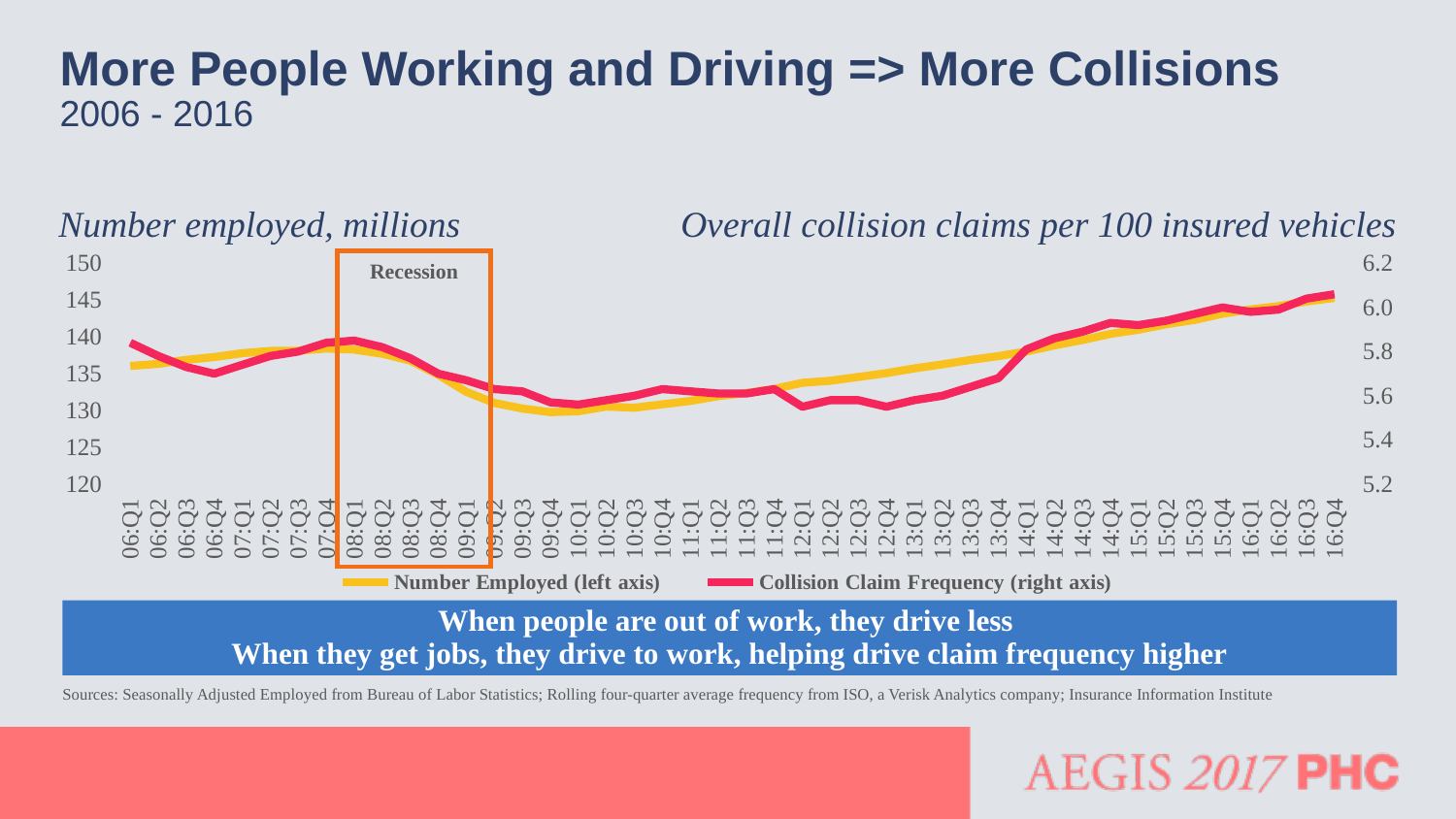
Which series is plotted against the left axis according to the legend? Number Employed Is the value for Collision Claim Frequency at 16:Q4 greater or less than 5.8? greater Does the Number Employed series rise or fall between 08:Q1 and 09:Q4? Fall Is the value for Number Employed at 06:Q1 greater or less than 130? greater Is the value for Number Employed at 16:Q4 greater or less than 140? greater What kind of chart is shown on the slide? Line chart Does the Collision Claim Frequency series rise or fall between 13:Q4 and 16:Q4? Rise How many quarterly points are plotted along the x axis of the chart? 44 How many series does the chart's legend list? 2 What label is shown inside the orange box on the chart? Recession